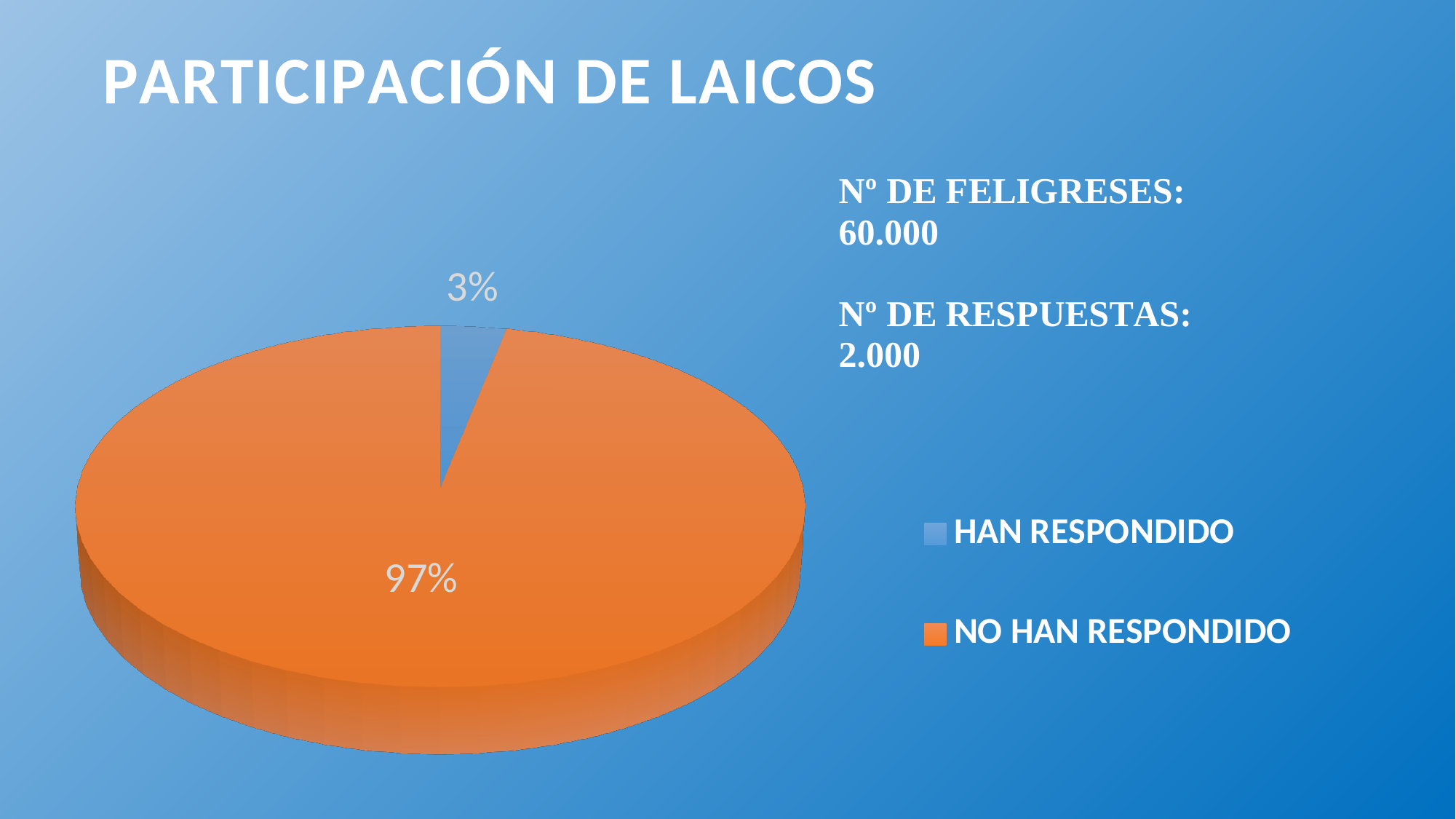
What kind of chart is shown on the slide? pie chart What is the difference in percentage points between the NO HAN RESPONDIDO and HAN RESPONDIDO slices? 94 Which is larger, the HAN RESPONDIDO slice or the NO HAN RESPONDIDO slice? NO HAN RESPONDIDO Which slice of the pie is the smallest? HAN RESPONDIDO What colour is the NO HAN RESPONDIDO slice? orange How many entries does the legend list? 2 How many slices does the pie chart have? 2 Which slice of the pie is the largest? NO HAN RESPONDIDO What share of the pie does HAN RESPONDIDO represent? 3% What share of the pie does NO HAN RESPONDIDO represent? 97% What colour is the HAN RESPONDIDO slice? blue